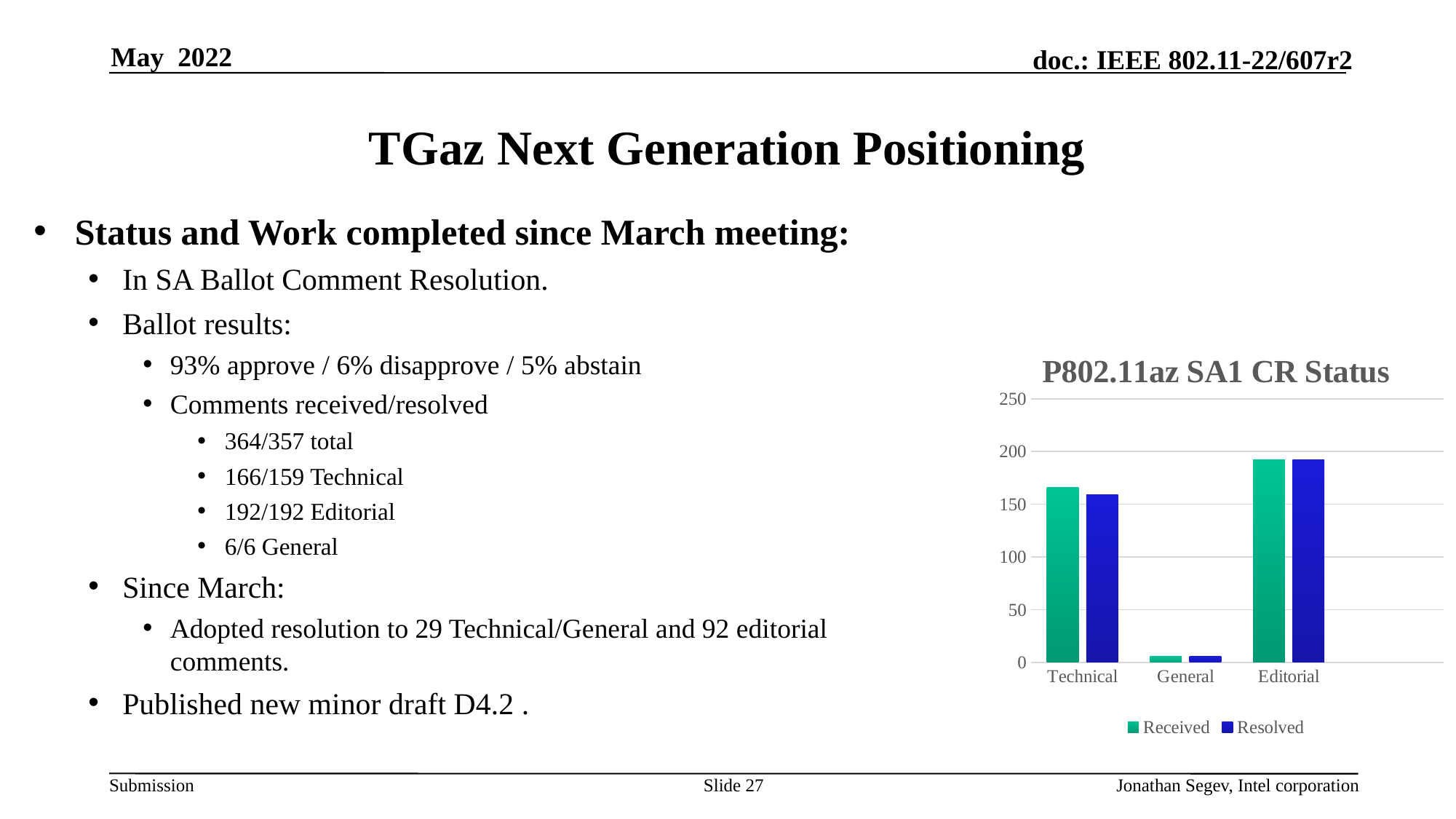
Is the Received value for Technical greater or less than 150? greater How many categories are shown on the x axis of the chart? 3 Is the Resolved value for General greater or less than 50? less Which is larger, the Resolved value for Technical or the Resolved value for General? Technical Which category has the lowest Resolved value? General What are the two series named in the chart legend? Received and Resolved What is the title of the chart? P802.11az SA1 CR Status Is the Received value for Editorial greater or less than 200? less Which is larger, the Received value for Editorial or the Received value for Technical? Editorial What type of chart is shown on the slide? bar chart How many series does the chart legend list? 2 Which category has the highest Received value? Editorial